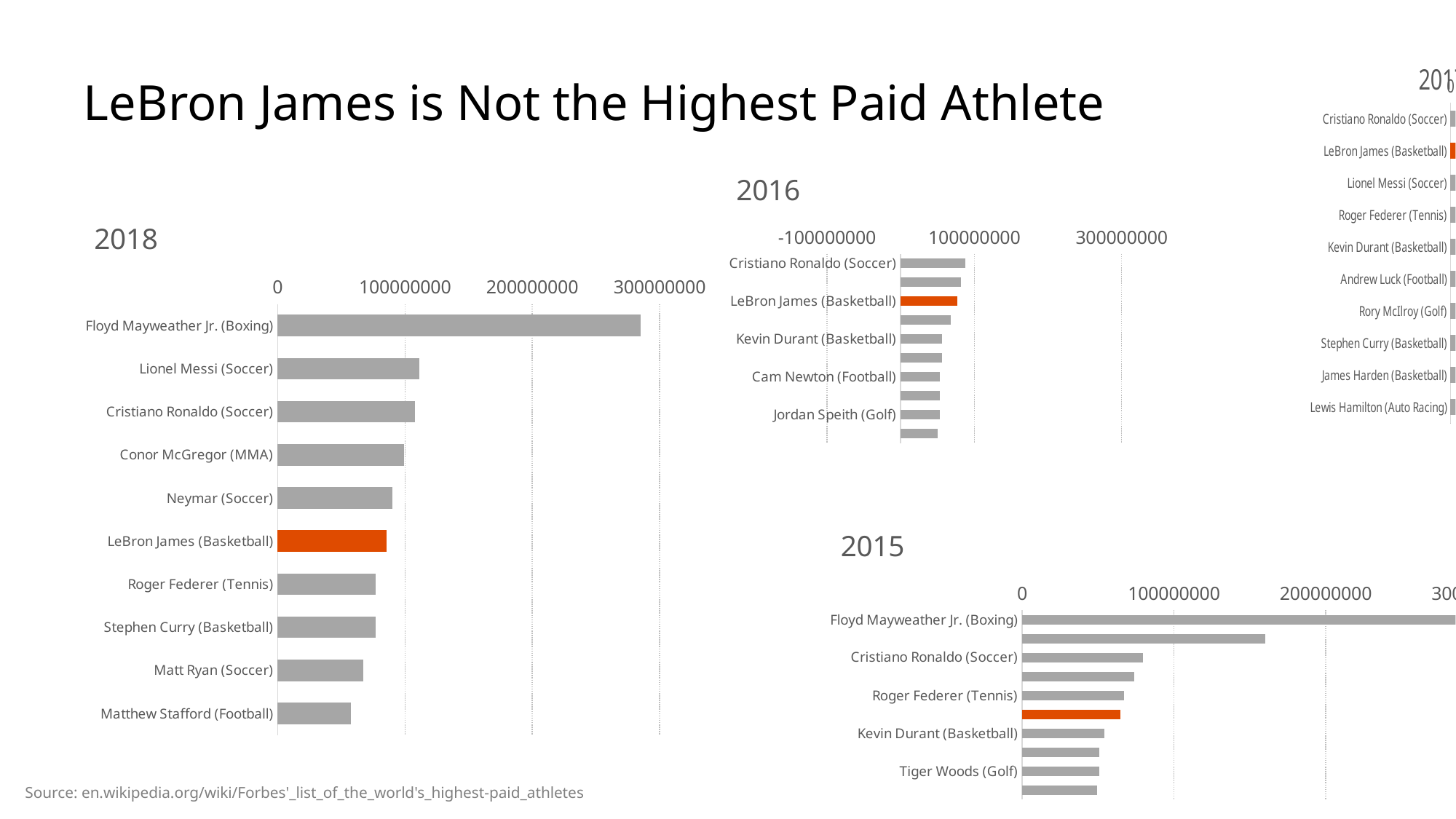
In the 2018 chart, which athlete has the highest value? Floyd Mayweather Jr. (Boxing) In the 2018 chart, is the value for Matthew Stafford (Football) greater or less than 100000000? less In the 2018 chart, is the value for Floyd Mayweather Jr. (Boxing) greater or less than 200000000? greater Which athlete's bar is highlighted in orange across the charts? LeBron James (Basketball) In the 2018 chart, which is larger, the value for Floyd Mayweather Jr. (Boxing) or the value for LeBron James (Basketball)? Floyd Mayweather Jr. (Boxing) In the 2016 chart, which labeled athlete has the highest value? Cristiano Ronaldo (Soccer) In the 2015 chart, which athlete has the highest value? Floyd Mayweather Jr. (Boxing) In the 2018 chart, how many athletes are listed? 10 In the 2018 chart, which athlete has the lowest value? Matthew Stafford (Football) What kind of chart is the 2018 chart? bar chart In the 2015 chart, which is larger, the value for Cristiano Ronaldo (Soccer) or the value for Tiger Woods (Golf)? Cristiano Ronaldo (Soccer) In the 2015 chart, is the value for Kevin Durant (Basketball) greater or less than 100000000? less